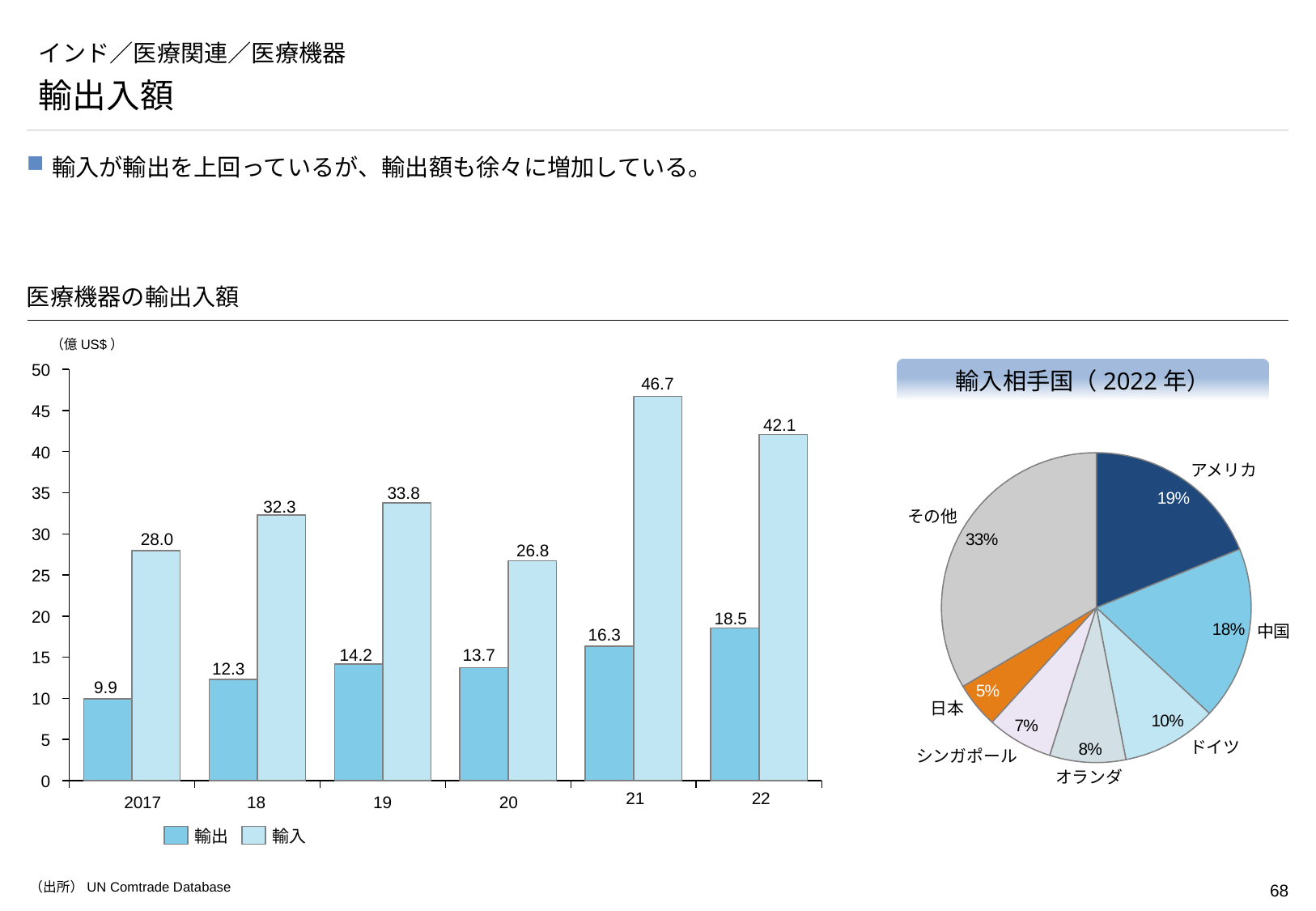
In the bar chart 医療機器の輸出入額, how many years are shown on the x axis? 6 In the bar chart 医療機器の輸出入額, which year has the lowest 輸出 value? 2017 What kind of chart is 輸入相手国（2022年）? pie chart In the bar chart 医療機器の輸出入額, what is the difference between 輸入 and 輸出 in 21? 30.4 In the pie chart 輸入相手国（2022年）, which named country has the smallest share? 日本 In the bar chart 医療機器の輸出入額, what is the 輸入 value for 2017? 28.0 In the bar chart 医療機器の輸出入額, is the 輸出 value for 19 larger or smaller than the 輸出 value for 20? larger In the bar chart 医療機器の輸出入額, what is the 輸出 value for 22? 18.5 In the pie chart 輸入相手国（2022年）, what is the difference between the shares of アメリカ and ドイツ? 9% In the bar chart 医療機器の輸出入額, which year has the highest 輸入 value? 21 In the pie chart 輸入相手国（2022年）, what share does 中国 have? 18% In the bar chart 医療機器の輸出入額, how many series does the legend list? 2